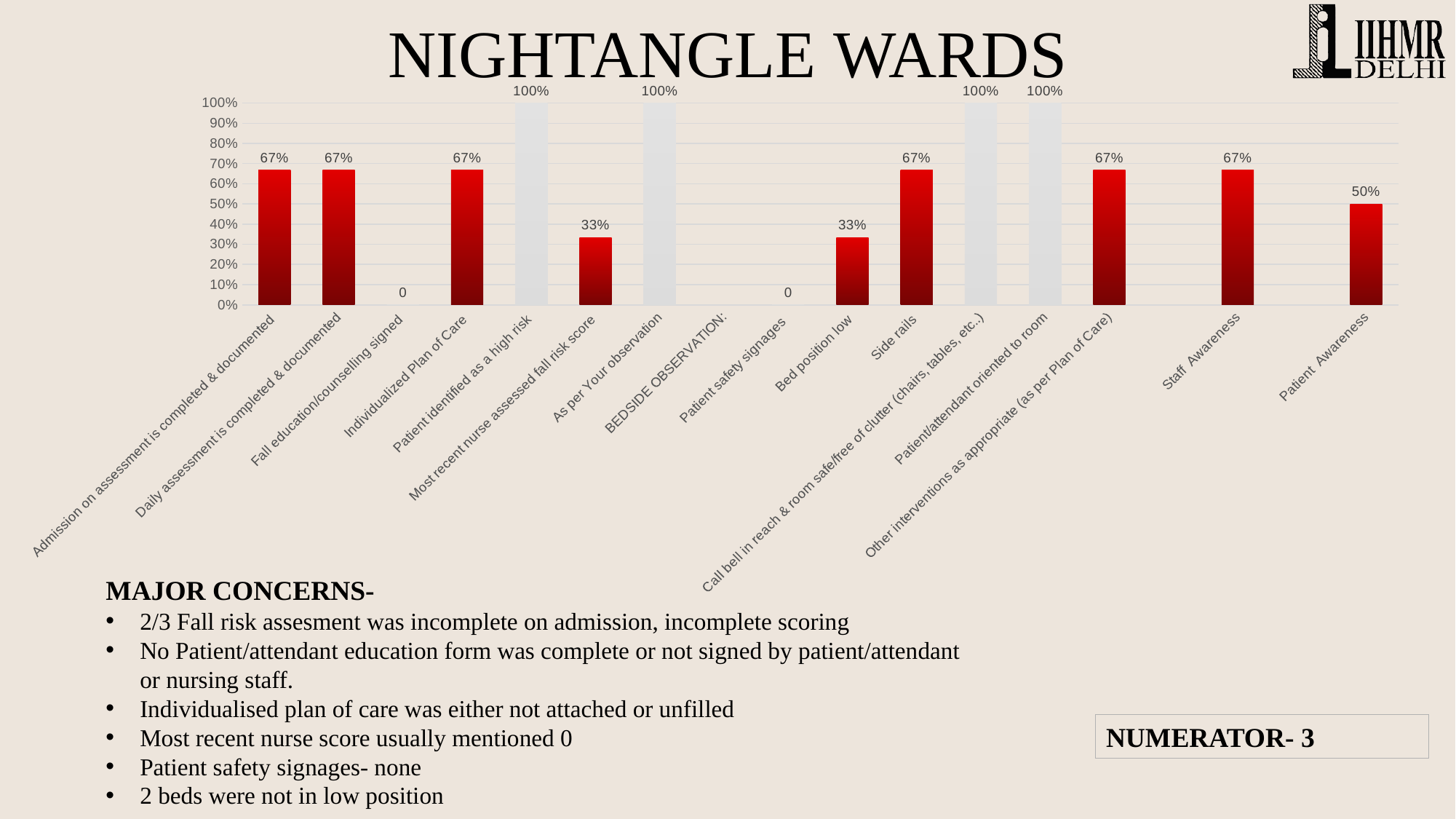
Which is larger, the value for Individualized Plan of Care or the value for Most recent nurse assessed fall risk score? Individualized Plan of Care What is the difference between the values for Side rails and Bed position low? 34% What is the value for Bed position low? 33% What is the difference between the values for Staff Awareness and Patient Awareness? 17% Which is larger, the value for Staff Awareness or the value for Patient Awareness? Staff Awareness What is the value for Side rails? 67% What value is shown for Fall education/counselling signed? 0 What kind of chart is shown on the slide? Bar chart What is the value for Most recent nurse assessed fall risk score? 33% What is the value for Patient Awareness? 50% What is the value for Patient/attendant oriented to room? 100% What is the title of the slide containing the chart? NIGHTANGLE WARDS